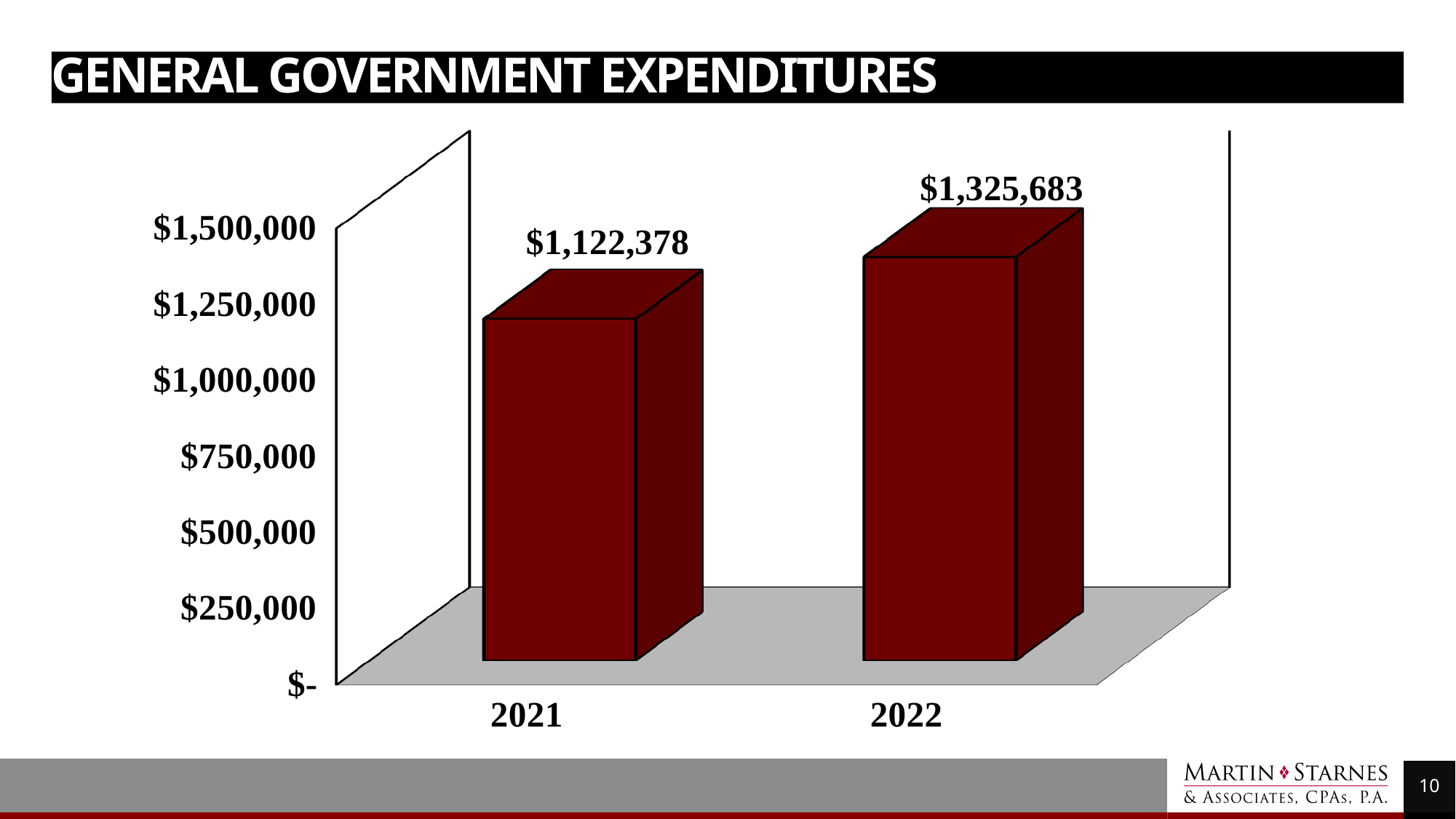
What is the value for 2022? $1,325,683 What kind of chart is shown on the slide? bar chart What is the difference between the 2022 and 2021 values? $203,305 Do the values rise or fall from 2021 to 2022? rise Is the value for 2021 greater or less than $1,000,000? greater How many years are shown on the chart? 2 Is the value for 2022 greater or less than $1,500,000? less What is the title of the slide? GENERAL GOVERNMENT EXPENDITURES Which year has the lowest general government expenditures? 2021 What is the value for 2021? $1,122,378 Which year has the highest general government expenditures? 2022 Which is larger, the value for 2021 or the value for 2022? 2022